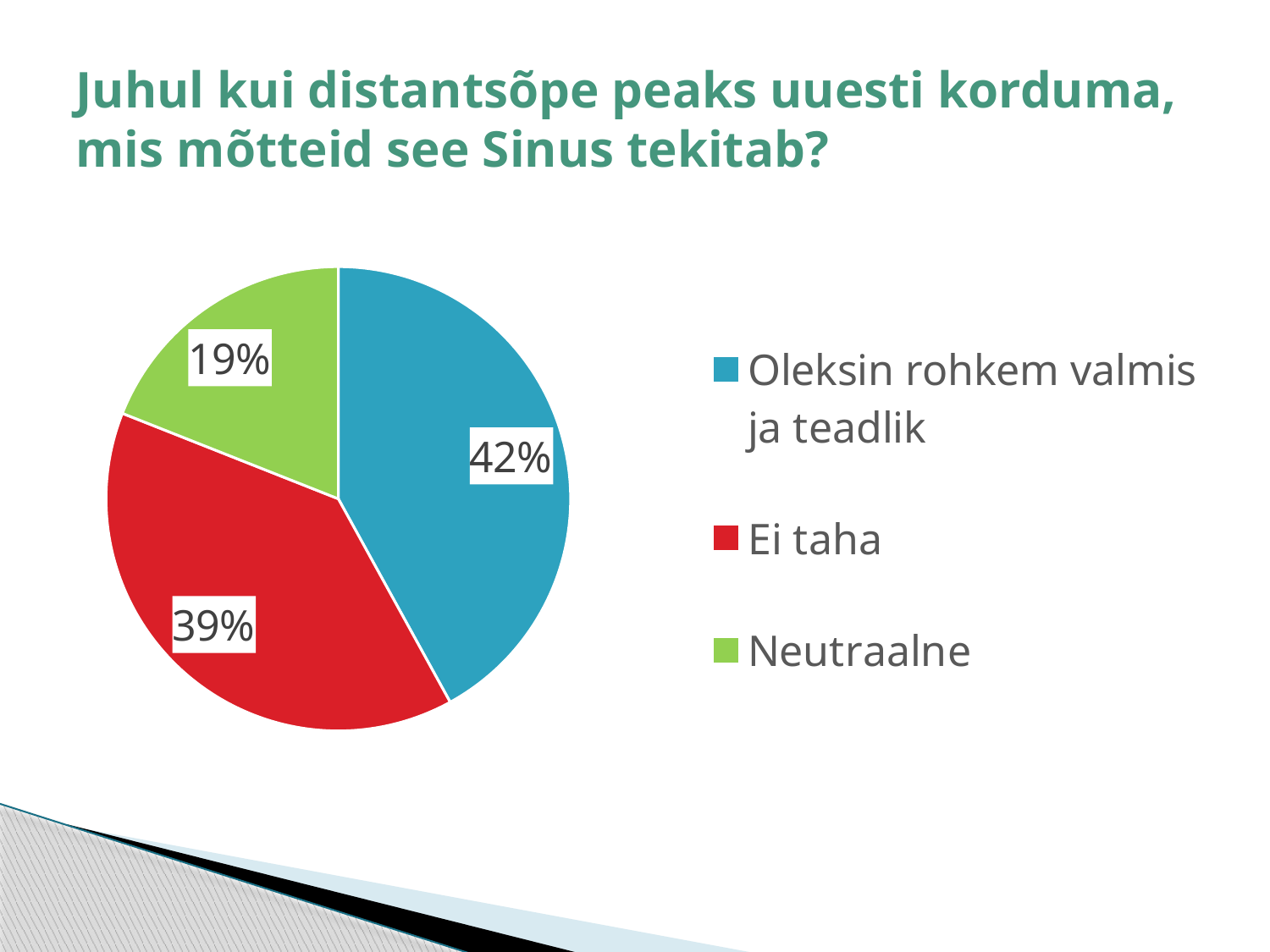
What is the difference in percentage points between "Oleksin rohkem valmis ja teadlik" and "Ei taha"? 3 percentage points Which category has the largest slice of the pie? Oleksin rohkem valmis ja teadlik What colour is the slice for "Ei taha"? Red What share of the pie does "Neutraalne" have? 19% What type of chart is shown on the slide? Pie chart What share of the pie does "Ei taha" have? 39% Which is larger: the share for "Ei taha" or the share for "Neutraalne"? Ei taha Which category is shown in green in the legend? Neutraalne Which category has the smallest slice of the pie? Neutraalne How many categories does the pie chart show? 3 What share of the pie does "Oleksin rohkem valmis ja teadlik" have? 42% What is the difference in percentage points between "Ei taha" and "Neutraalne"? 20 percentage points